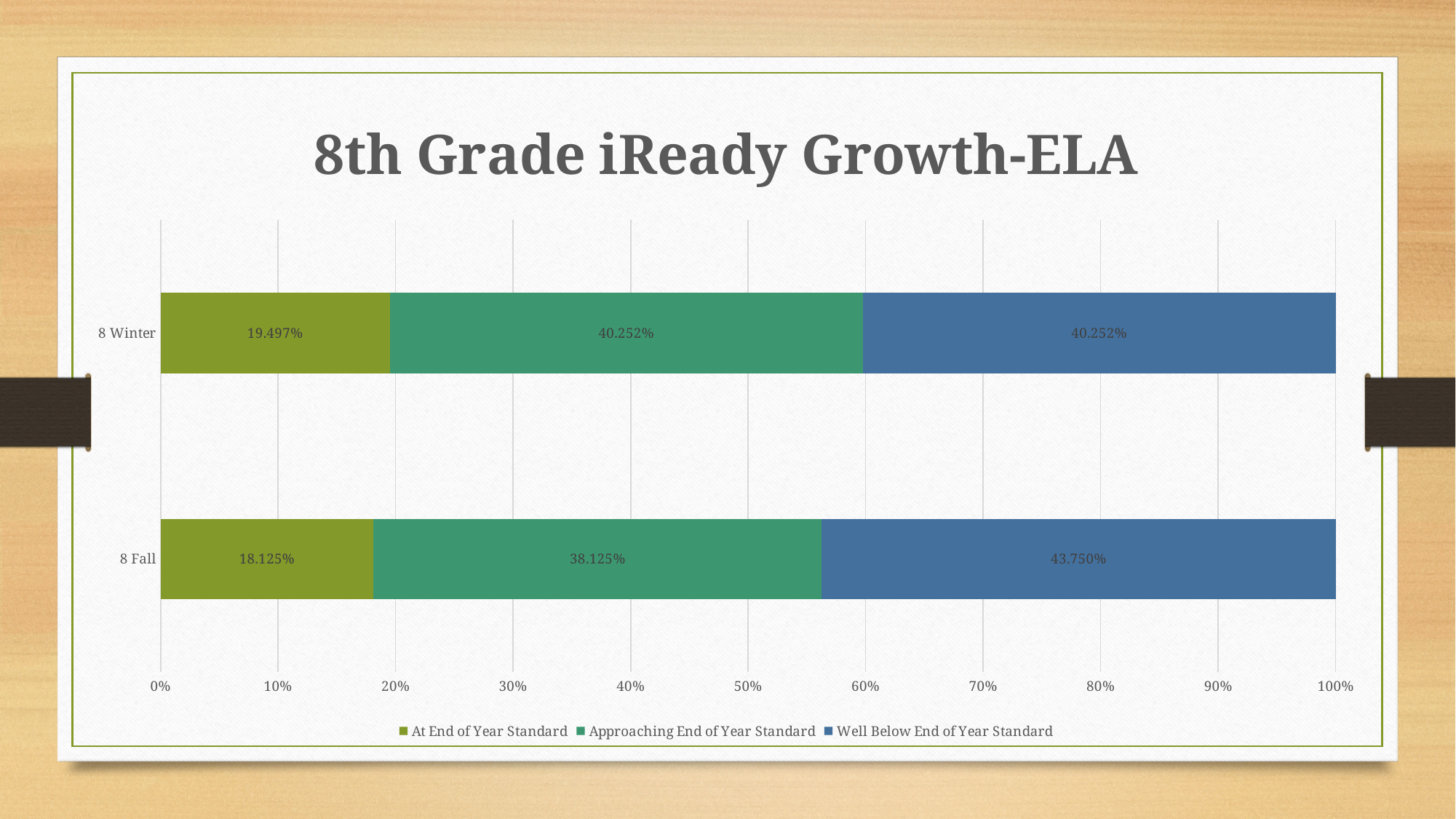
Which is larger in 8 Fall: Approaching End of Year Standard or Well Below End of Year Standard? Well Below End of Year Standard What is the value for Well Below End of Year Standard in 8 Fall? 43.750% What is the difference between the Well Below End of Year Standard values for 8 Fall and 8 Winter? 3.498% What is the total of the 8 Fall stacked bar? 100% What is the value for At End of Year Standard in 8 Winter? 19.497% What is the title of the chart? 8th Grade iReady Growth-ELA What kind of chart is shown on the slide? Stacked bar chart Which series has the smallest value in the 8 Winter bar? At End of Year Standard What is the value for Approaching End of Year Standard in 8 Fall? 38.125% Which series has the largest value in the 8 Fall bar? Well Below End of Year Standard How many series does the legend list? 3 How many categories are plotted on the chart? 2